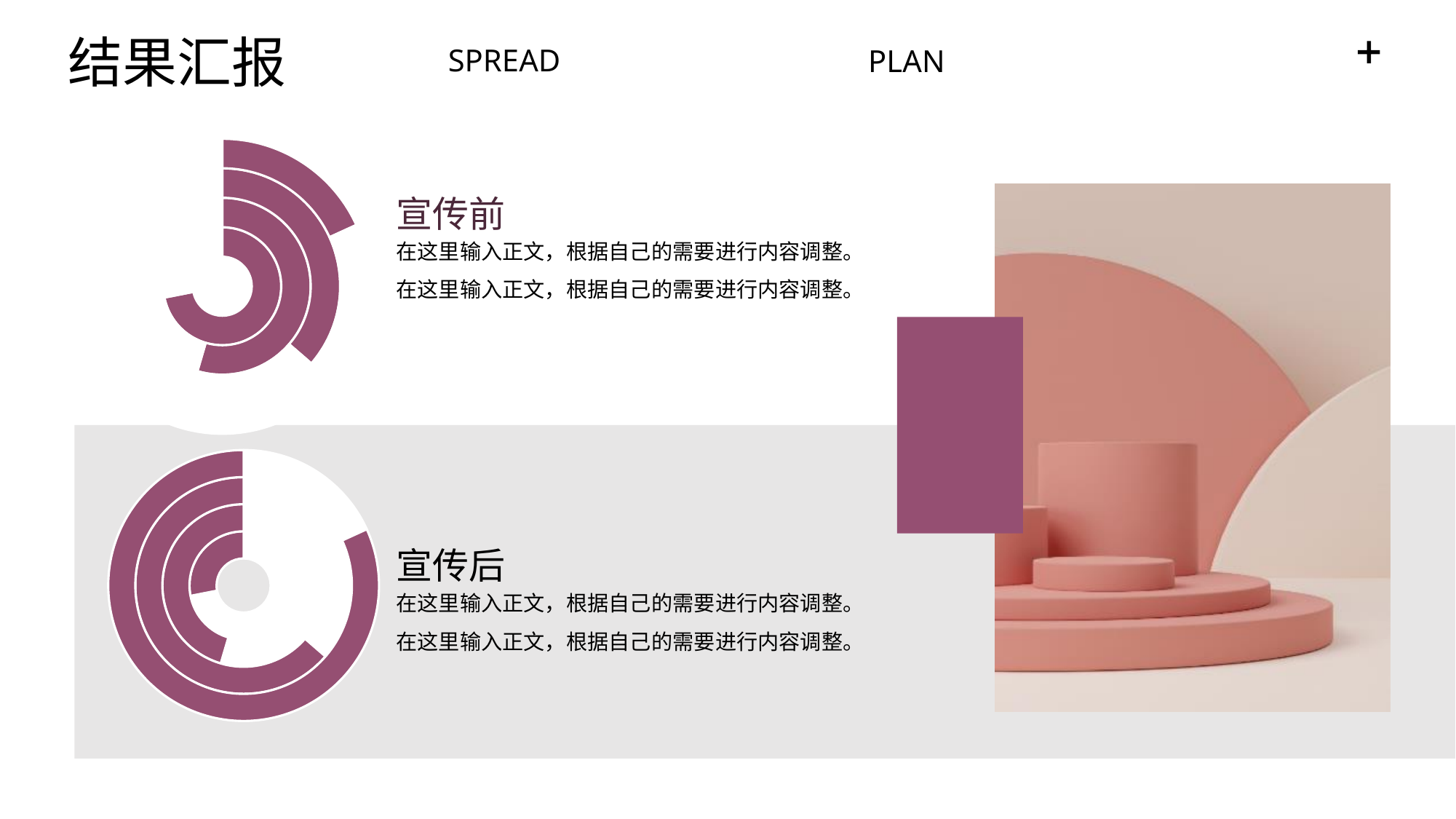
What kind of chart is the top chart next to 宣传前? doughnut chart What colour are the arcs in both charts on the slide? purple Does either chart on the slide display a legend? No How many rings (arcs) does the bottom chart next to 宣传后 contain? 4 What kind of chart is the bottom chart next to 宣传后? doughnut chart How many rings (arcs) does the top chart next to 宣传前 contain? 4 In the bottom chart next to 宣传后, which ring is longer, the outermost or the innermost? outermost